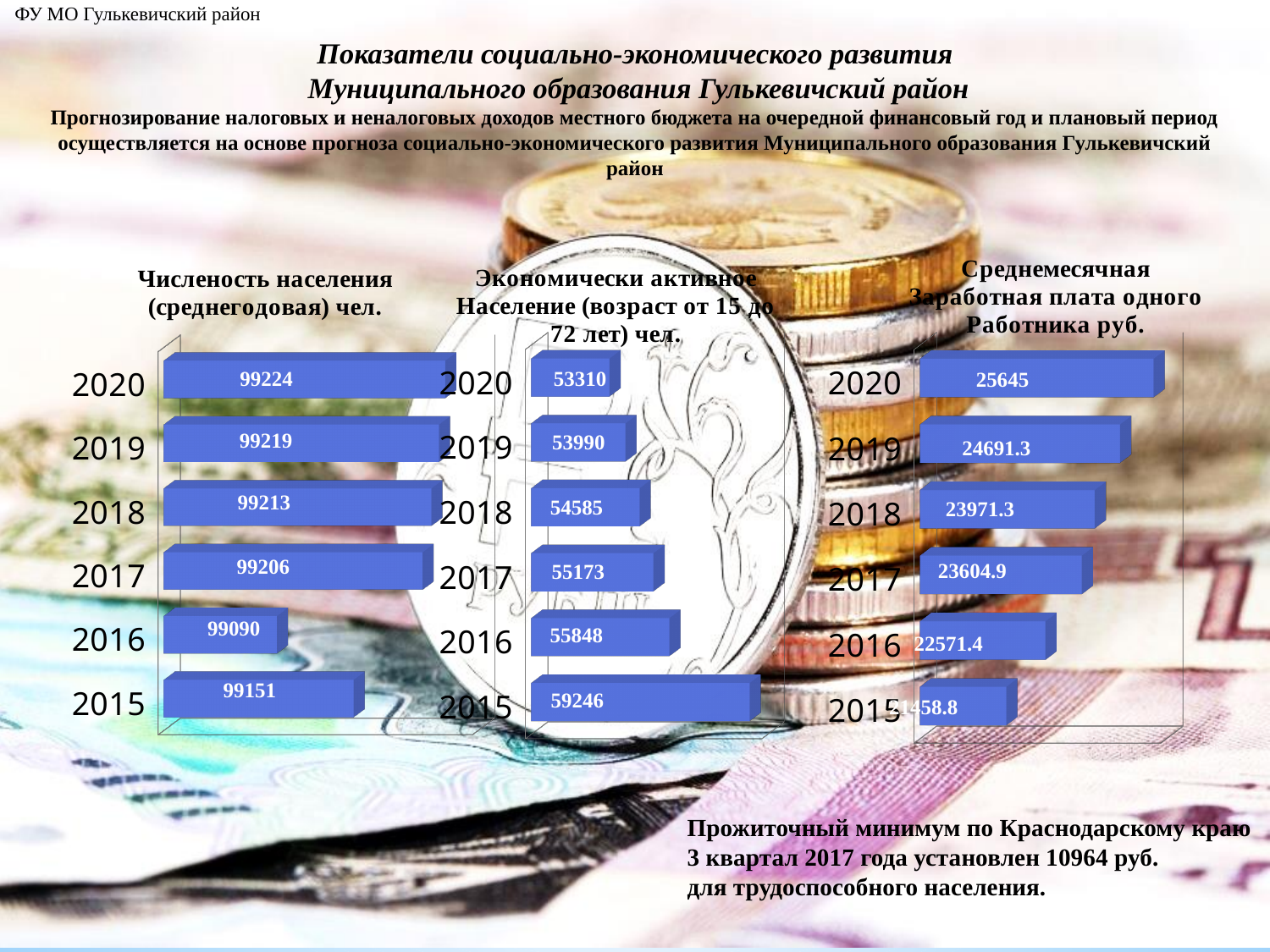
In the chart 'Экономически активное Население (возраст от 15 до 72 лет) чел.', what is the difference between the values for 2015 and 2020? 5936 In the chart 'Экономически активное Население (возраст от 15 до 72 лет) чел.', do the values rise or fall from 2015 to 2020? fall In the chart 'Экономически активное Население (возраст от 15 до 72 лет) чел.', which year has the highest value? 2015 In the chart 'Численость населения (среднегодовая) чел.', what is the difference between the values for 2015 and 2016? 61 In the chart 'Численость населения (среднегодовая) чел.', which year has the lowest value? 2016 In the chart 'Экономически активное Население (возраст от 15 до 72 лет) чел.', what is the value for 2017? 55173 How many years are shown in the chart 'Численость населения (среднегодовая) чел.'? 6 What type of chart is the chart 'Среднемесячная Заработная плата одного Работника руб.'? bar chart In the chart 'Среднемесячная Заработная плата одного Работника руб.', which is larger, the value for 2017 or the value for 2018? 2018 In the chart 'Среднемесячная Заработная плата одного Работника руб.', which year has the highest value? 2020 In the chart 'Численость населения (среднегодовая) чел.', what is the value for 2020? 99224 In the chart 'Среднемесячная Заработная плата одного Работника руб.', what is the value for 2019? 24691.3